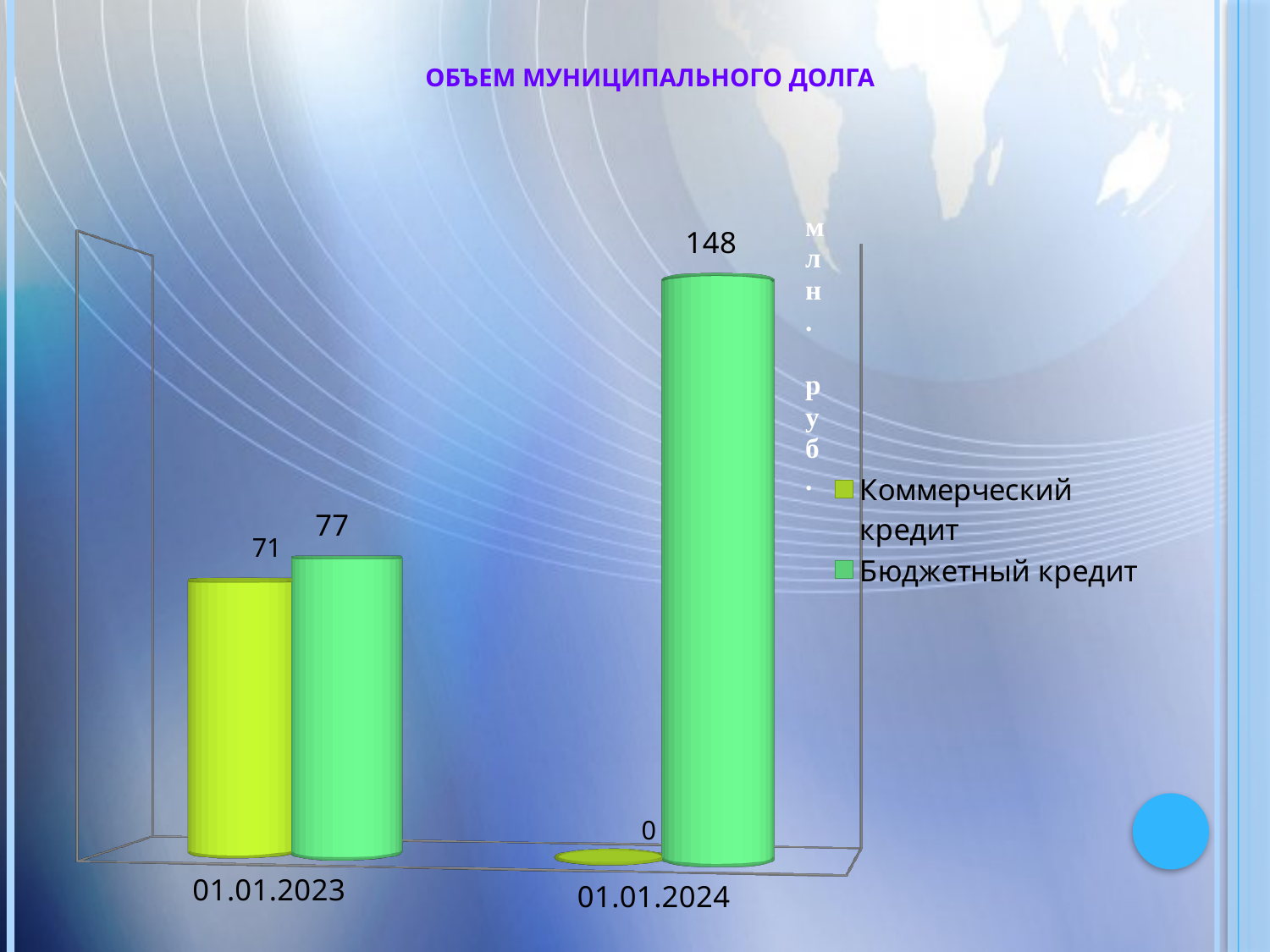
What is the title of the chart? ОБЪЕМ МУНИЦИПАЛЬНОГО ДОЛГА What is the value of Коммерческий кредит on 01.01.2023? 71 How many series does the legend list? 2 Which date has the highest value for Бюджетный кредит? 01.01.2024 What is the value of Бюджетный кредит on 01.01.2023? 77 On 01.01.2023, which is larger: Коммерческий кредит or Бюджетный кредит? Бюджетный кредит What is the value of Бюджетный кредит on 01.01.2024? 148 What is the value of Коммерческий кредит on 01.01.2024? 0 Which date has the lowest value for Коммерческий кредит? 01.01.2024 What is the difference between Бюджетный кредит on 01.01.2024 and on 01.01.2023? 71 What kind of chart is shown on the slide? Bar chart How many dates are shown on the x axis? 2